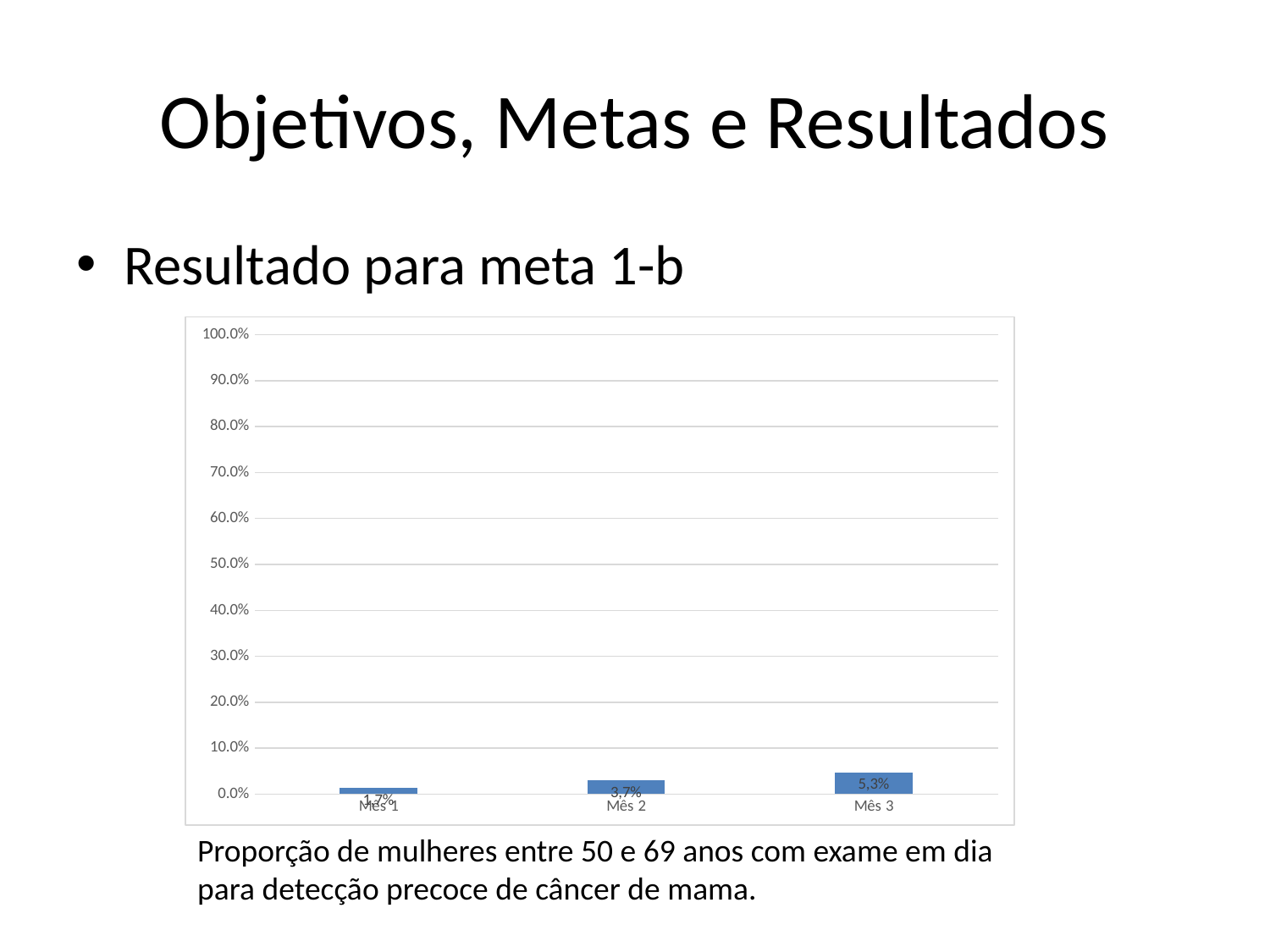
Do the values rise or fall from Mês 1 to Mês 3? rise What is the value for Mês 3? 5,3% What is the value for Mês 2? 3,7% What is the difference between the values for Mês 3 and Mês 2? 1,6% What kind of chart is shown on the slide? bar chart Which is larger, the value for Mês 2 or the value for Mês 3? Mês 3 How many months are shown on the x axis? 3 What is the value for Mês 1? 1,7% What is the maximum value shown on the y axis? 100.0% Is the value for Mês 3 greater or less than 10.0%? less Which month has the lowest value? Mês 1 Which month has the highest value? Mês 3